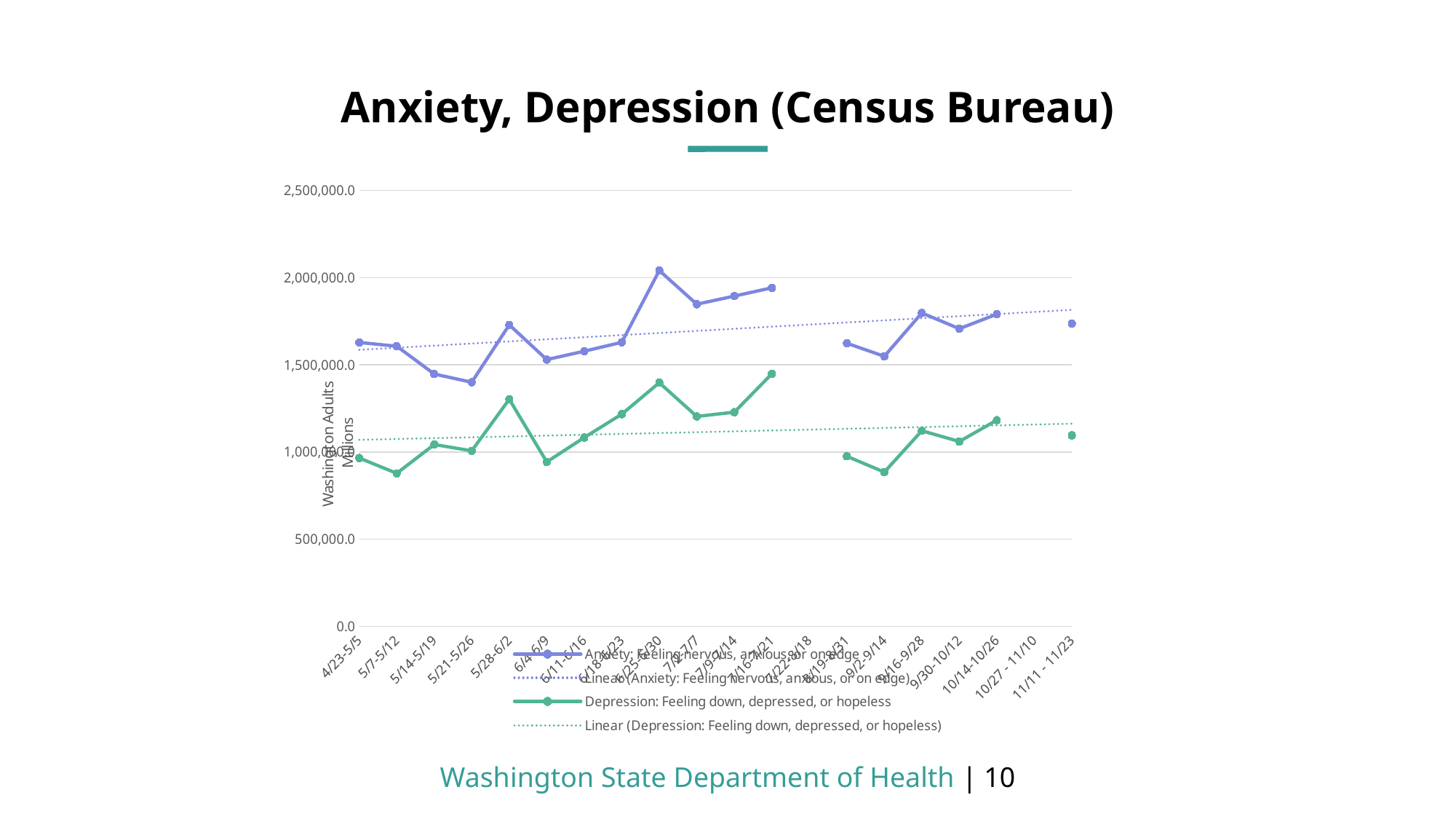
Is the value for Anxiety at 9/16-9/28 greater or less than 1,500,000.0? greater At 5/28-6/2, which series has the larger value, Anxiety or Depression? Anxiety How many entries does the chart legend list? 4 Is the value for Depression at 5/7-5/12 greater or less than 1,000,000.0? less Is the value for Depression at 10/14-10/26 greater or less than 1,000,000.0? greater What is the title of the chart on the slide? Anxiety, Depression (Census Bureau) Which colour is used for the Depression series line? Green What type of chart is shown on the slide? Line chart Does the linear trendline for the Anxiety series rise or fall from left to right? Rise